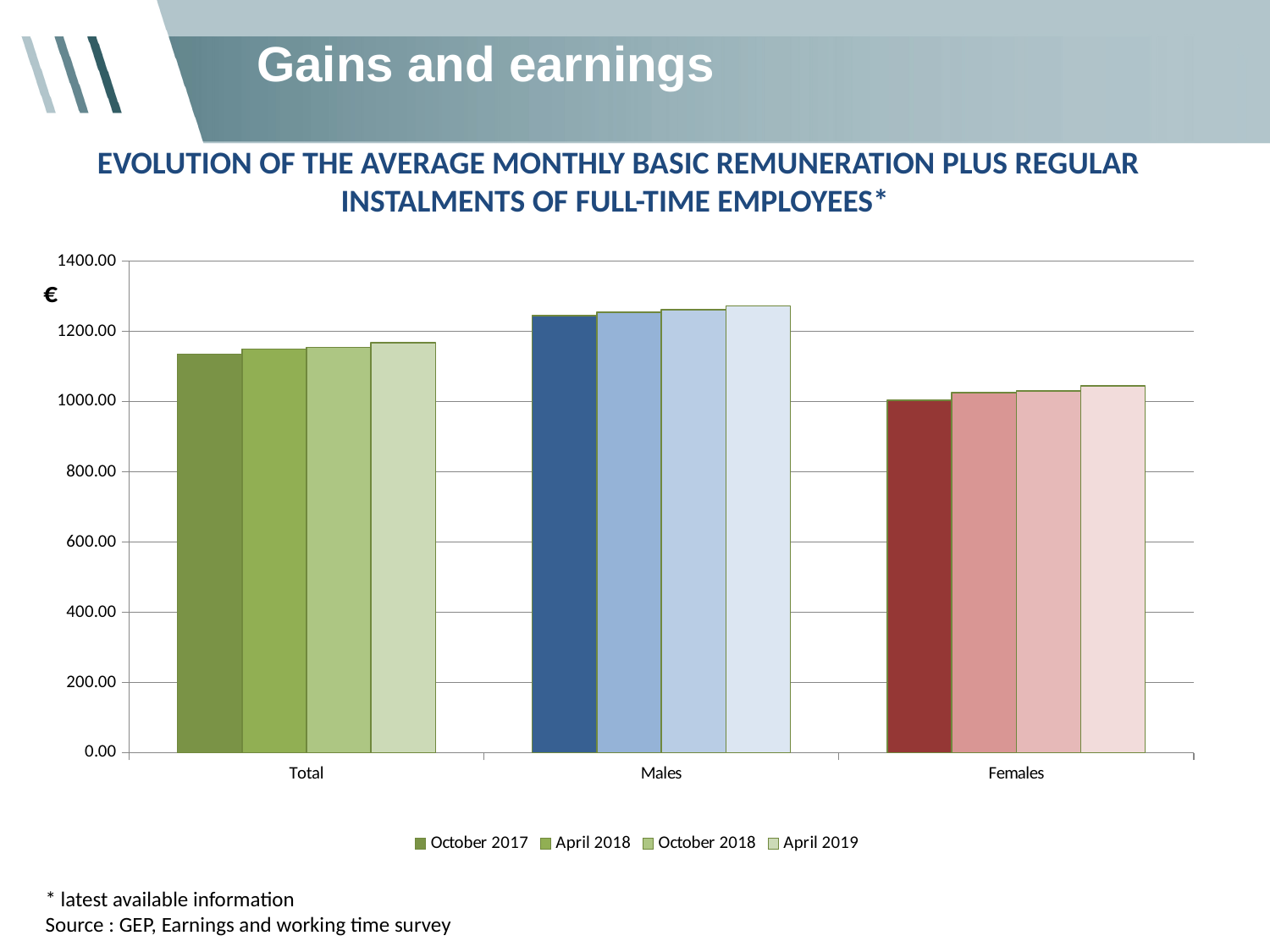
Is the value for Total in October 2017 greater or less than 1000? greater Which category has the highest value for April 2019? Males What kind of chart is shown on the slide? bar chart Is the value for Females in April 2019 greater or less than 1200? less How many categories are shown on the x axis of the chart? 3 Is the value for Males in October 2017 greater or less than 1200? greater What currency symbol is shown next to the vertical axis of the chart? € Which series is listed first in the chart's legend? October 2017 Which category has the lowest value for October 2017? Females How many series does the chart's legend list? 4 Do the values for Total rise or fall from October 2017 to April 2019? rise Which is larger in October 2017, the value for Males or the value for Females? Males